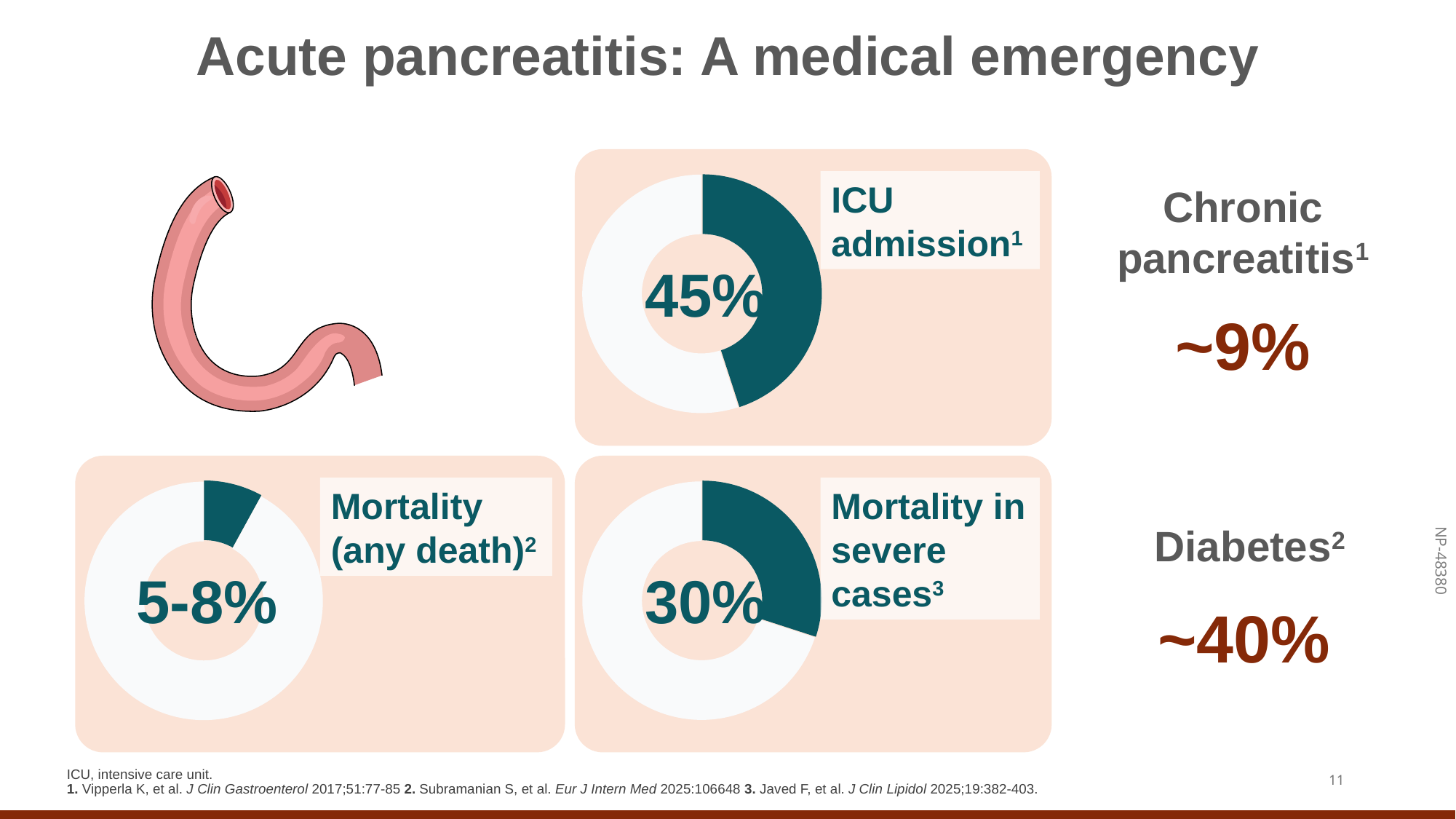
What value is shown in the centre of the ICU admission donut chart? 45% Is the filled share of the ICU admission donut chart greater or less than half of the ring? less How many donut charts are shown on the slide? 3 Which donut chart shows the lowest percentage: ICU admission, Mortality (any death), or Mortality in severe cases? Mortality (any death) What colour is the filled segment in the donut charts? Dark teal Which is larger, the ICU admission percentage or the Mortality in severe cases percentage? ICU admission What value is shown in the centre of the Mortality in severe cases donut chart? 30% What value is shown in the centre of the Mortality (any death) donut chart? 5-8% Which donut chart is labelled with the superscript reference 3? Mortality in severe cases Which donut chart shows the highest percentage: ICU admission, Mortality (any death), or Mortality in severe cases? ICU admission What is the difference between the ICU admission percentage and the Mortality in severe cases percentage? 15% What kind of chart is used to show the ICU admission figure? Donut (pie) chart